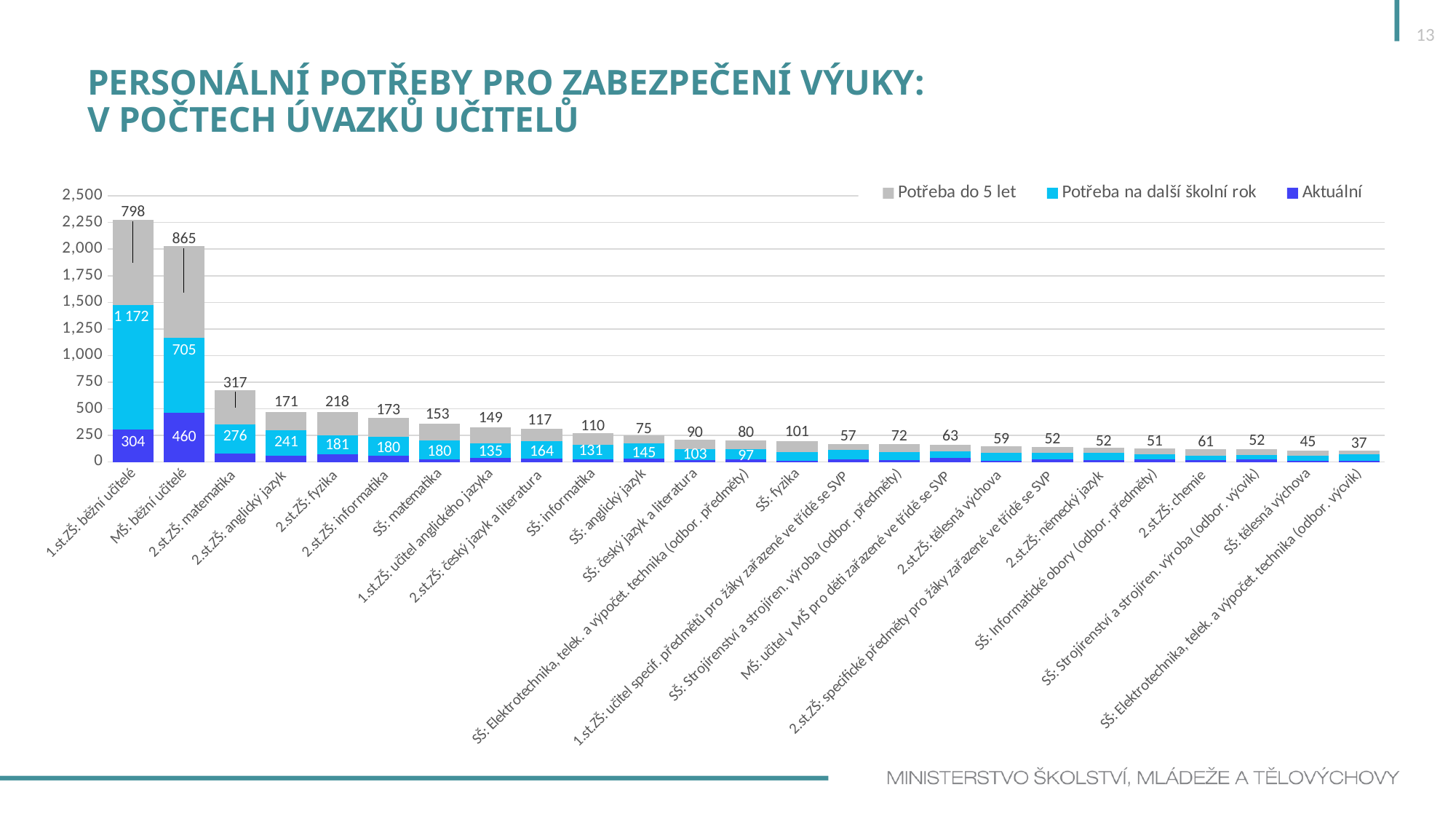
How many categories are plotted on the x axis? 25 Is the total stacked bar for '2.st.ZŠ: matematika' greater or less than 500? greater Which category has the highest total stacked bar? 1.st.ZŠ: běžní učitelé What is the 'Potřeba na další školní rok' value for '1.st.ZŠ: běžní učitelé'? 1 172 What is the 'Potřeba do 5 let' value for '2.st.ZŠ: matematika'? 317 What is the 'Aktuální' value for 'MŠ: běžní učitelé'? 460 Which is larger, the 'Potřeba do 5 let' value for '2.st.ZŠ: fyzika' or for '2.st.ZŠ: anglický jazyk'? 2.st.ZŠ: fyzika What kind of chart is shown on the slide? stacked bar chart What is the difference between the 'Potřeba do 5 let' values for 'MŠ: běžní učitelé' and '1.st.ZŠ: běžní učitelé'? 67 What is the total of the stacked bar for 'MŠ: běžní učitelé'? 2,030 How many series does the legend list? 3 What is the 'Potřeba na další školní rok' value for '2.st.ZŠ: český jazyk a literatura'? 164